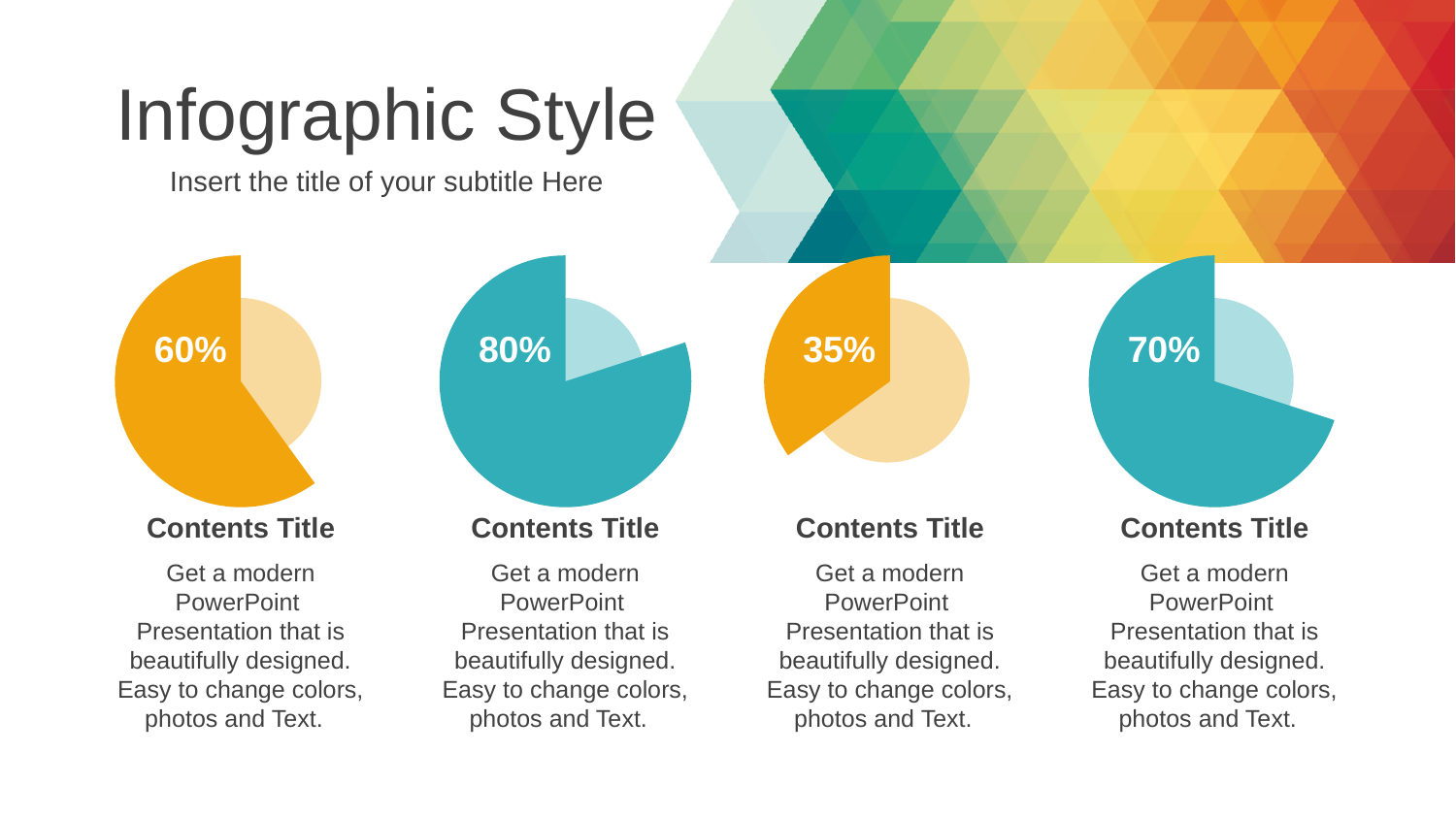
What percentage is shown on the second pie chart from the left? 80% What kind of chart is used for each of the four figures on the slide? Pie chart What percentage is shown on the leftmost pie chart? 60% How many pie charts are on the slide? 4 What is the difference between the percentage on the second pie chart and the percentage on the third pie chart? 45% Which of the four pie charts shows the highest percentage? The second from the left (80%) Which of the four pie charts shows the lowest percentage? The third from the left (35%) What is the difference between the percentage on the rightmost pie chart and the percentage on the leftmost pie chart? 10% What percentage is shown on the third pie chart from the left? 35% What colour is the filled slice of the leftmost pie chart? Orange What percentage is shown on the rightmost pie chart? 70% Which is larger: the percentage on the leftmost pie chart or the percentage on the rightmost pie chart? The rightmost (70%)